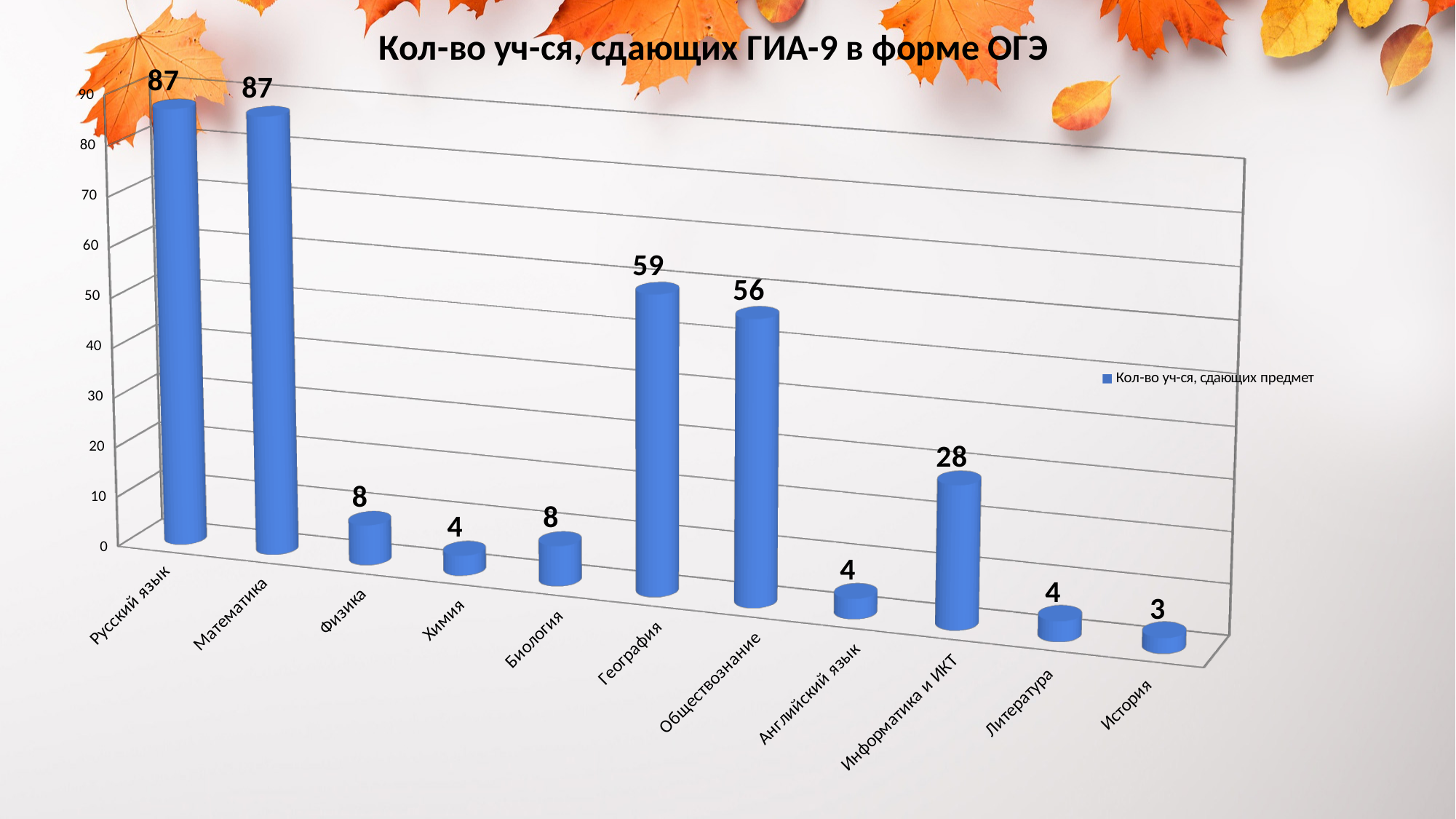
What is the value for Информатика и ИКТ? 28 What is the value for География? 59 Which category has the lowest value? История What is the difference between the values for География and Обществознание? 3 How many categories are shown on the x axis? 11 What is the value for Обществознание? 56 How many series does the legend list? 1 What kind of chart is shown on the slide? Bar chart What is the title of the chart? Кол-во уч-ся, сдающих ГИА-9 в форме ОГЭ Which is larger, the value for Обществознание or the value for Информатика и ИКТ? Обществознание What is the difference between the values for Русский язык and Информатика и ИКТ? 59 Which is larger, the value for Физика or the value for Химия? Физика